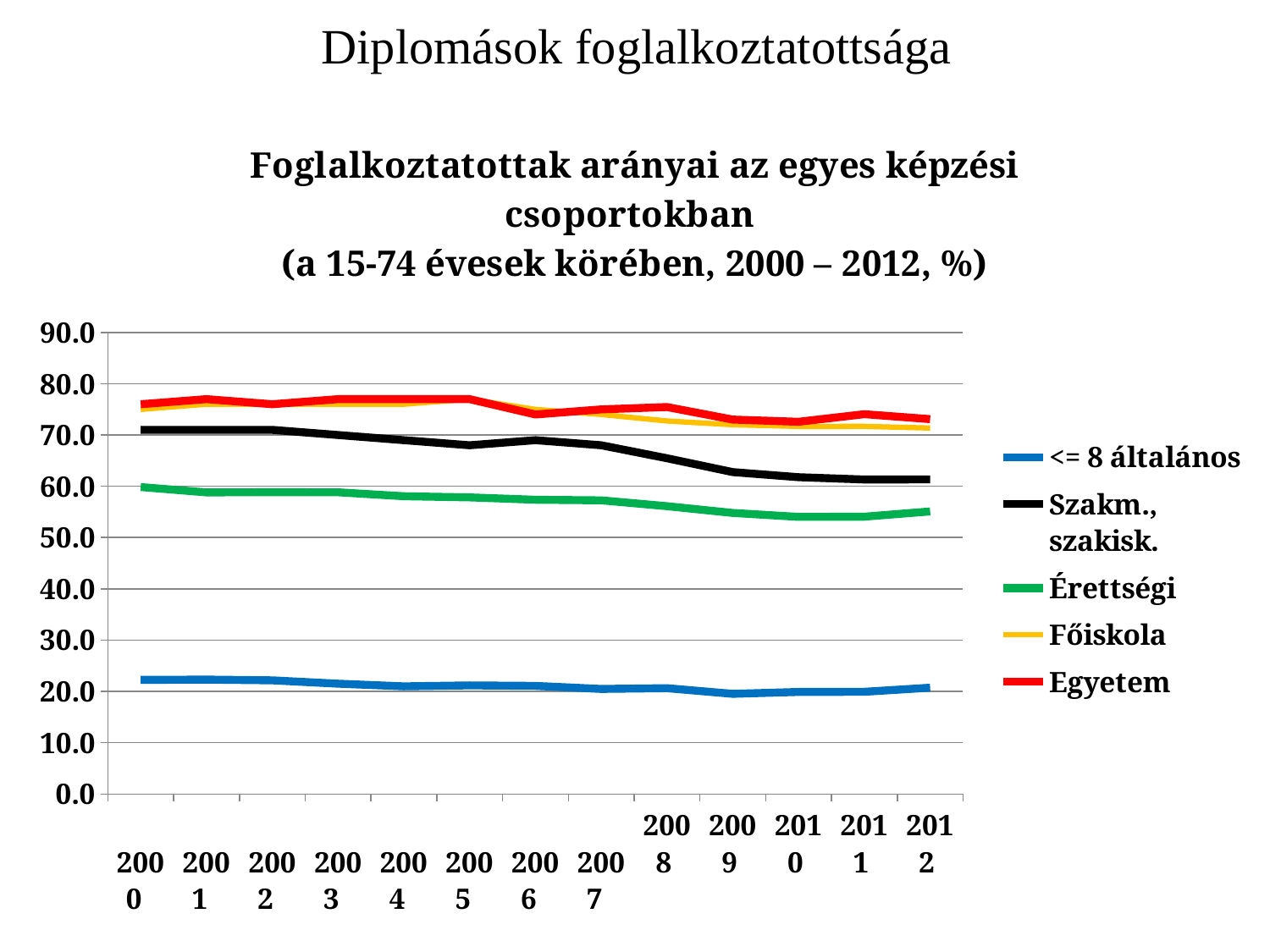
Is the value for '<= 8 általános' in 2000 greater or less than 30? less Is the value for 'Szakm., szakisk.' in 2012 greater or less than 70? less Does the 'Szakm., szakisk.' line rise or fall from 2000 to 2012? fall Is the value for 'Egyetem' in 2005 greater or less than 70? greater What kind of chart is shown on the slide? line chart How many series does the legend list? 5 Which series has the highest value in 2012? Egyetem Which series has the lowest values across all years? <= 8 általános What colour is the 'Érettségi' line? green How many years are shown along the x axis? 13 In 2008, which is larger: the value for 'Szakm., szakisk.' or for 'Érettségi'? Szakm., szakisk.